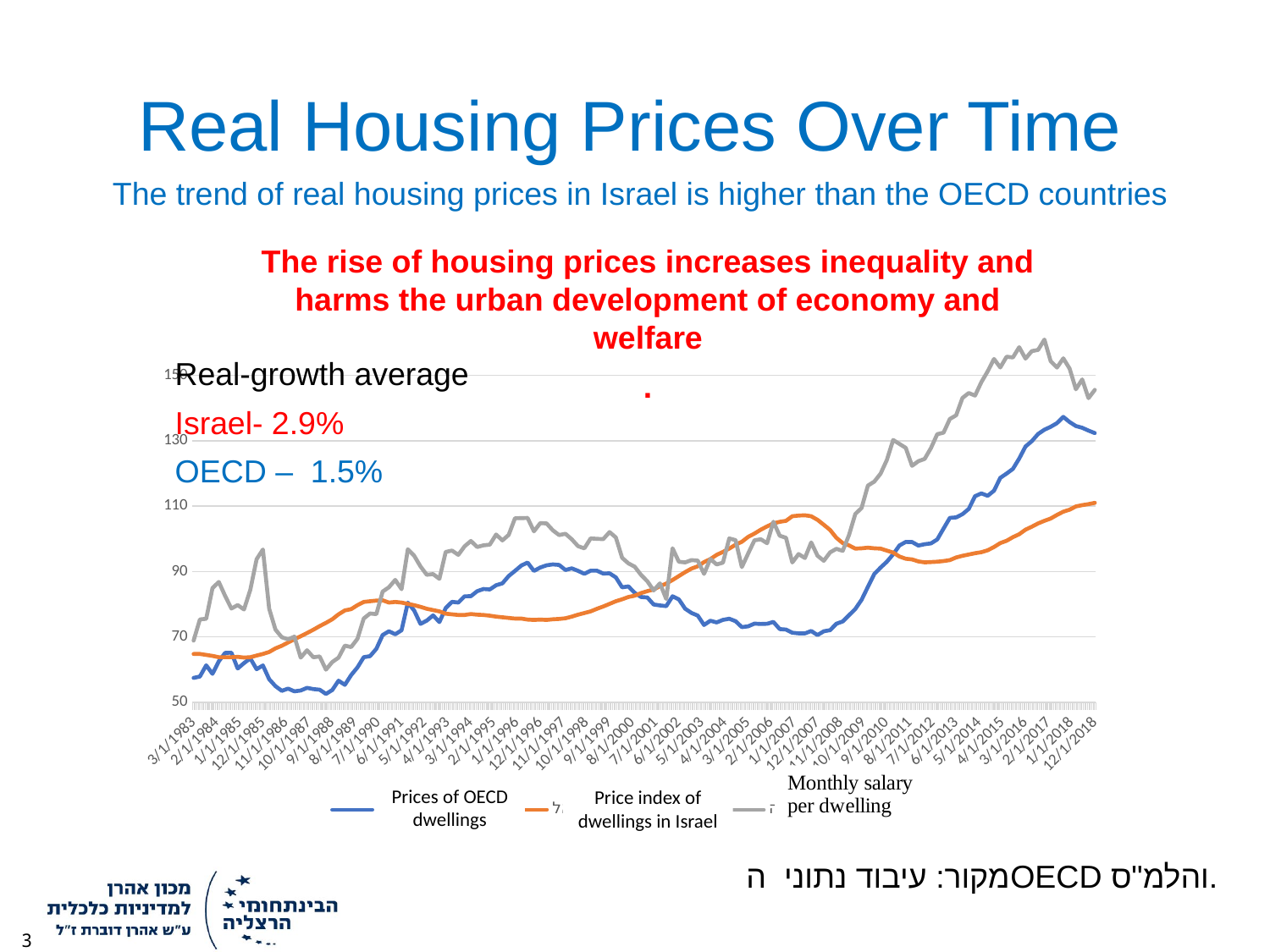
Is the value of Prices of OECD dwellings at 12/1/2018 greater or less than 110? greater What kind of chart is shown on the slide? line chart What is the title of the slide containing the chart? Real Housing Prices Over Time Is the value of Price index of dwellings in Israel at 3/1/1983 greater or less than 70? less How many series does the chart's legend list? 3 Is the value of Monthly salary per dwelling at 12/1/2018 greater or less than 130? greater At 12/1/2018, which series has the higher value: Prices of OECD dwellings or Price index of dwellings in Israel? Prices of OECD dwellings Which series has the highest value at the right end of the chart (12/1/2018)? Monthly salary per dwelling Which series is drawn in orange in the chart? Price index of dwellings in Israel Does the Price index of dwellings in Israel rise or fall between 2008 and 2018? rise At 12/1/2018, which series has the higher value: Monthly salary per dwelling or Prices of OECD dwellings? Monthly salary per dwelling